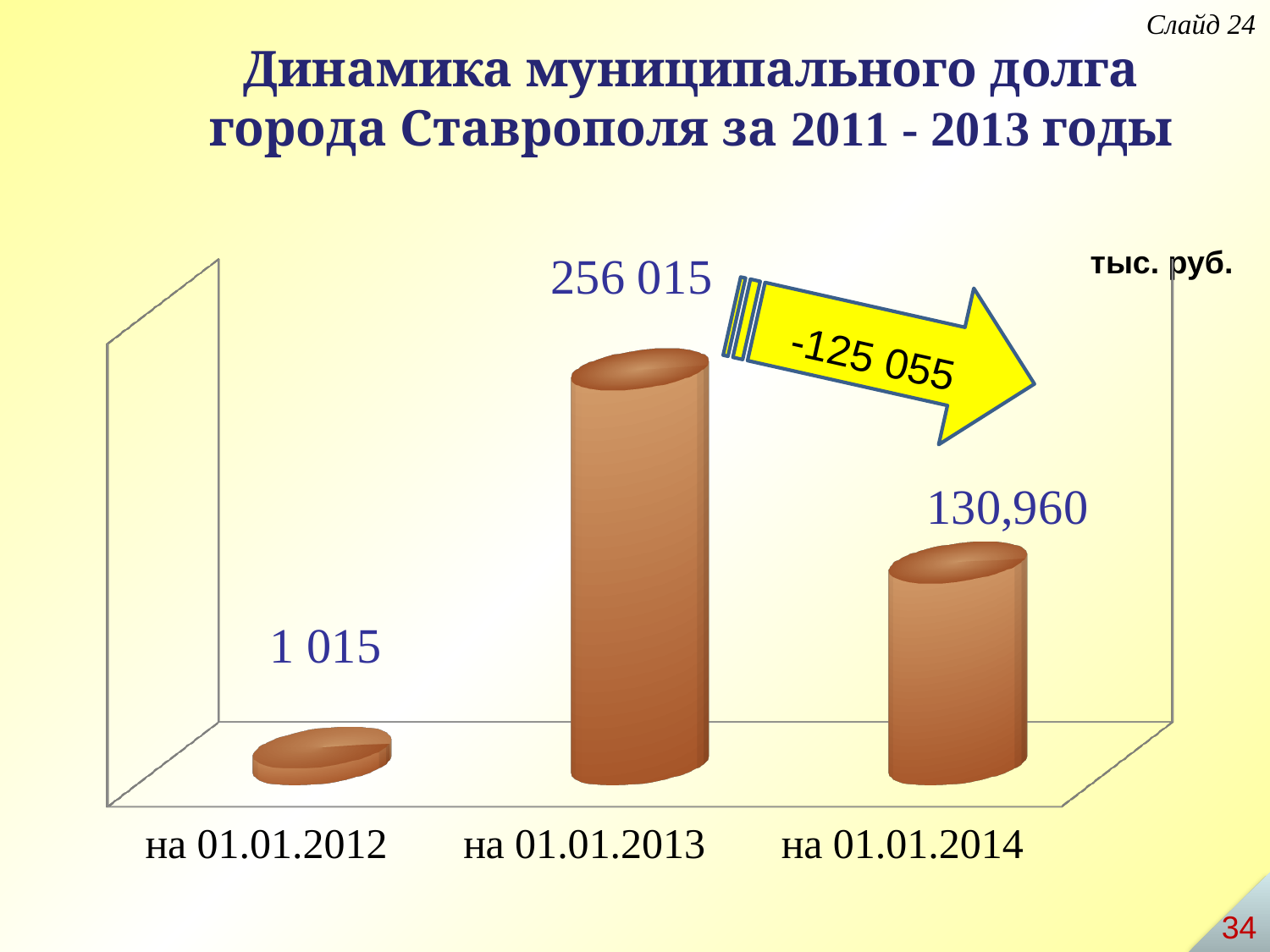
What is the change in municipal debt from 01.01.2013 to 01.01.2014 as labelled on the arrow? -125 055 How many dates (categories) are plotted on the chart? 3 What is the title of the chart on the slide? Динамика муниципального долга города Ставрополя за 2011 - 2013 годы Does the municipal debt rise or fall from 01.01.2013 to 01.01.2014? Fall What is the municipal debt value shown for на 01.01.2013? 256 015 What is the municipal debt value shown for на 01.01.2012? 1 015 Which date has the lowest municipal debt on the chart? на 01.01.2012 What is the municipal debt value shown for на 01.01.2014? 130,960 Which is larger, the debt on 01.01.2013 or the debt on 01.01.2014? на 01.01.2013 Which date has the highest municipal debt on the chart? на 01.01.2013 What kind of chart is shown on the slide? Bar chart In what units are the values on the chart expressed? тыс. руб.